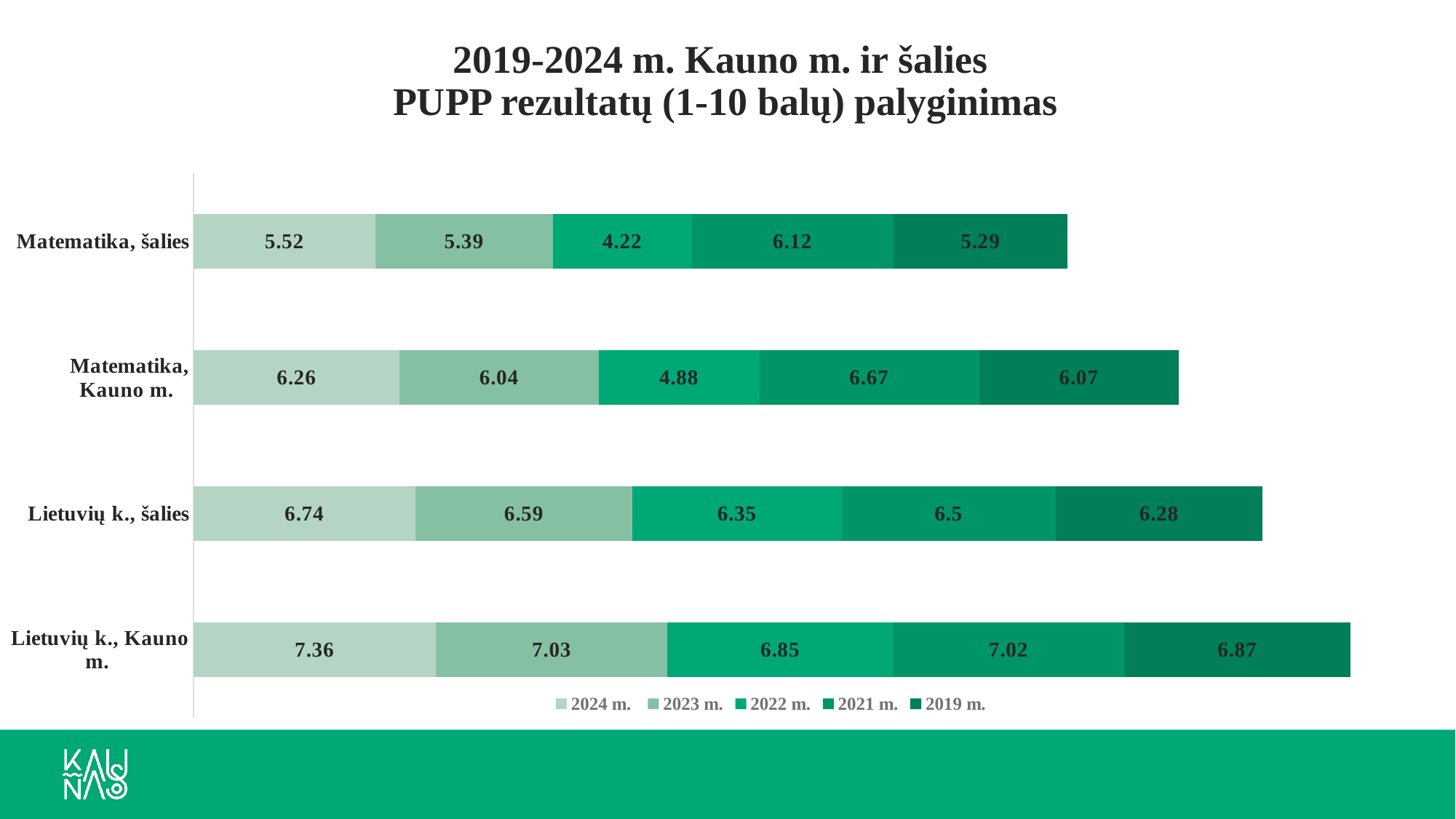
What is the 2022 m. value for Lietuvių k., Kauno m.? 6.85 What is the difference between the 2024 m. values for Matematika, Kauno m. and Matematika, šalies? 0.74 What is the 2021 m. value for Matematika, Kauno m.? 6.67 What is the total of the stacked bar for Lietuvių k., Kauno m.? 35.13 Which is larger: the 2023 m. value for Lietuvių k., šalies or the 2023 m. value for Lietuvių k., Kauno m.? Lietuvių k., Kauno m. What is the 2024 m. value for Matematika, šalies? 5.52 What kind of chart is shown on the slide? Stacked bar chart Which category has the lowest 2022 m. value? Matematika, šalies What is the 2019 m. value for Lietuvių k., šalies? 6.28 How many series does the legend list? 5 How many categories are shown on the chart? 4 Which category has the highest 2024 m. value? Lietuvių k., Kauno m.